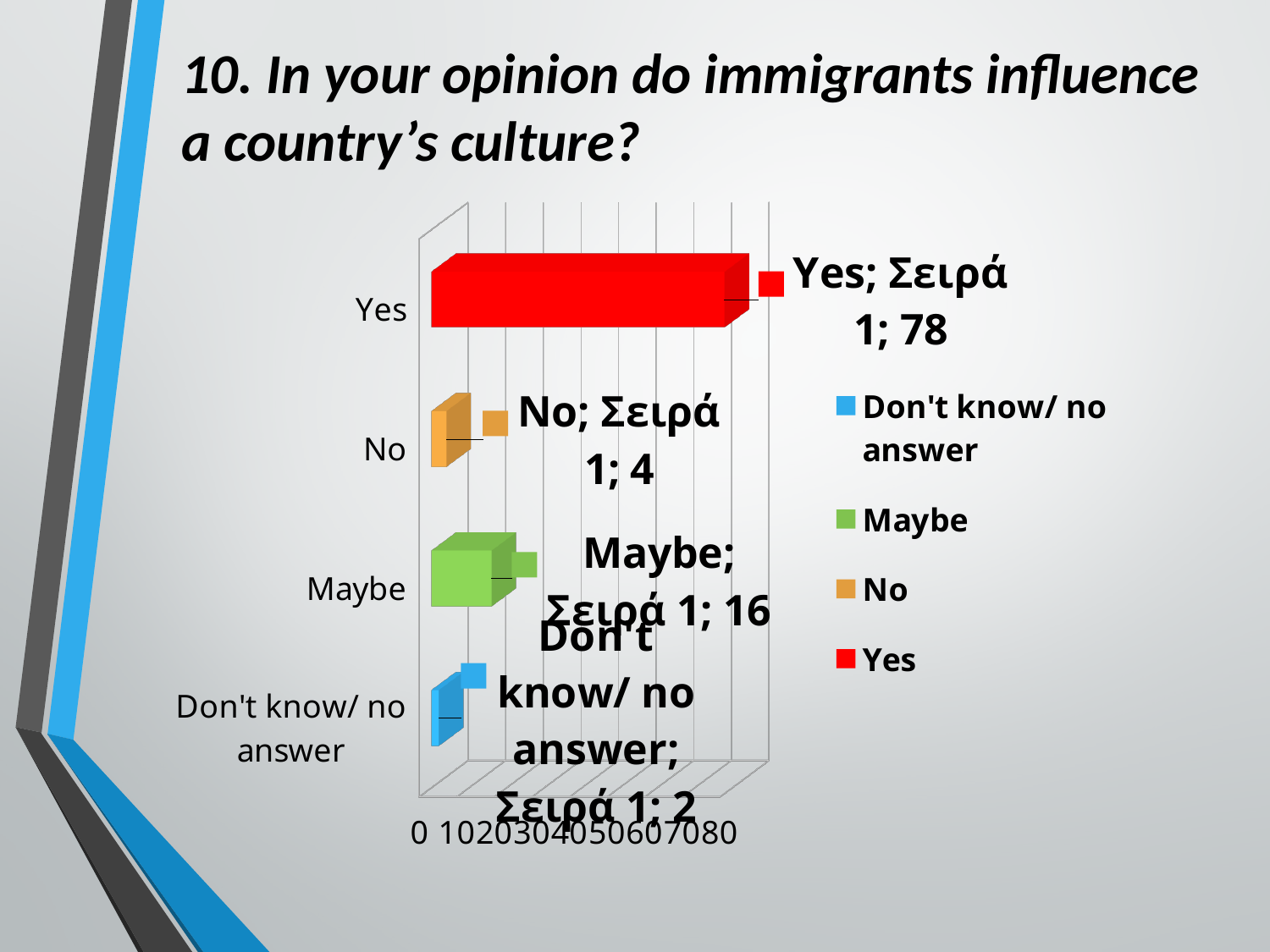
Which category has the highest value? Yes Which category has the lowest value? Don't know/ no answer How many categories are shown on the chart? 4 What kind of chart is shown on the slide? Bar chart What colour is the bar for Yes? Red What is the value for No? 4 Is the value for Yes greater or less than 70? greater What is the value for Yes? 78 What is the value for Don't know/ no answer? 2 Which is larger, the value for No or the value for Maybe? Maybe What is the difference between the values for Yes and Maybe? 62 What is the value for Maybe? 16